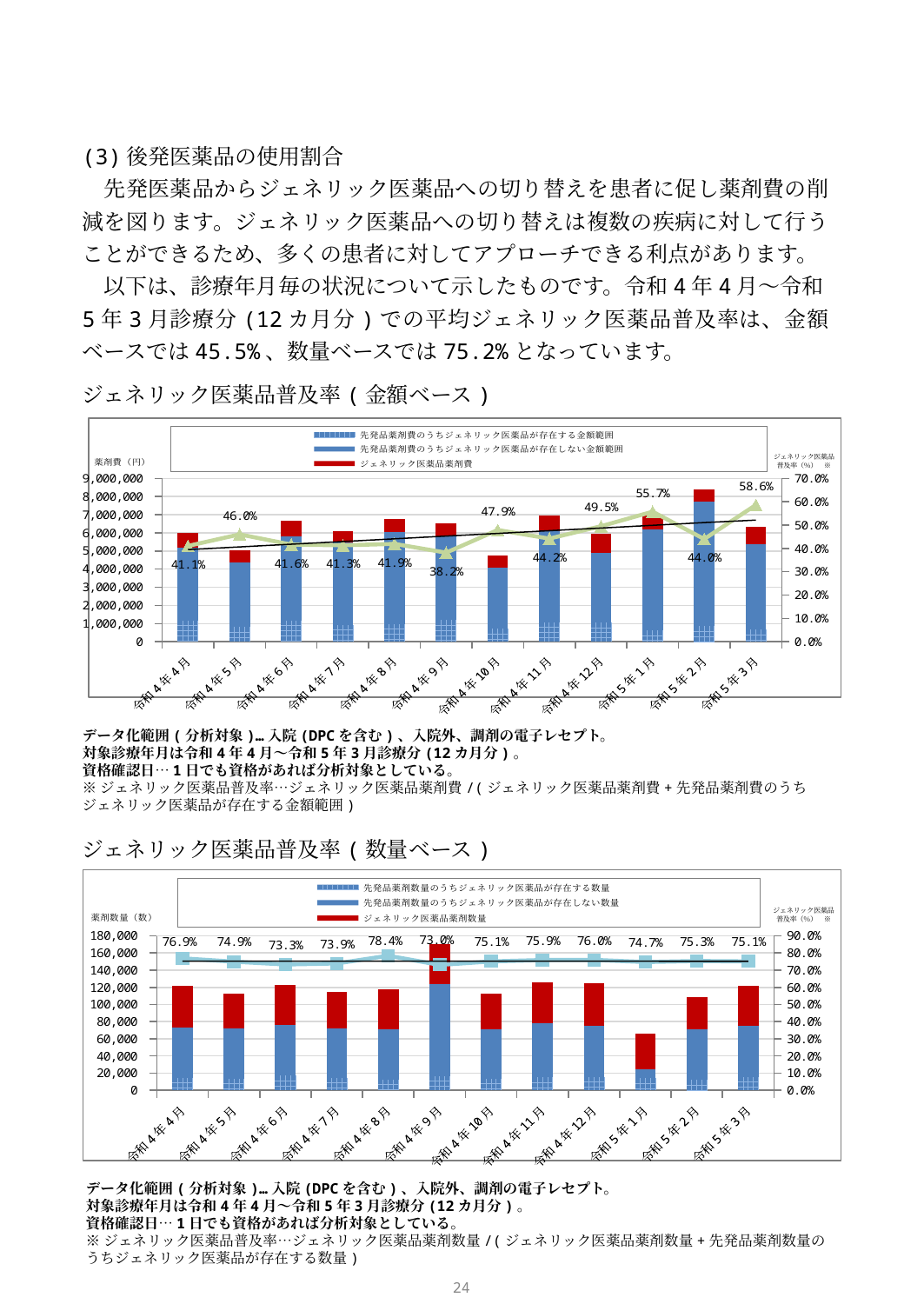
How many months are shown on the x axis of the 金額ベース chart (top)? 12 In the 数量ベース chart (bottom), what is the generic drug penetration rate for 令和5年1月? 74.7% How many entries does the legend of the 数量ベース chart (bottom) list? 3 In the 金額ベース chart (top), which month has the lowest generic drug penetration rate? 令和4年9月 In the 数量ベース chart (bottom), is the total stacked bar for 令和5年1月 greater or less than 80,000? less In the 金額ベース chart (top), what is the difference between the penetration rate for 令和5年3月 and 令和4年4月? 17.5 percentage points In the 数量ベース chart (bottom), which month has the lowest generic drug penetration rate? 令和4年9月 In the 金額ベース chart (top), what is the generic drug penetration rate for 令和5年3月? 58.6% What kind of chart is the 金額ベース chart (top)? A stacked bar chart combined with a line chart In the 金額ベース chart (top), which has the higher penetration rate, 令和4年5月 or 令和4年6月? 令和4年5月 In the 数量ベース chart (bottom), which month has the highest generic drug penetration rate? 令和4年8月 In the 金額ベース chart (top), which month has the highest generic drug penetration rate? 令和5年3月